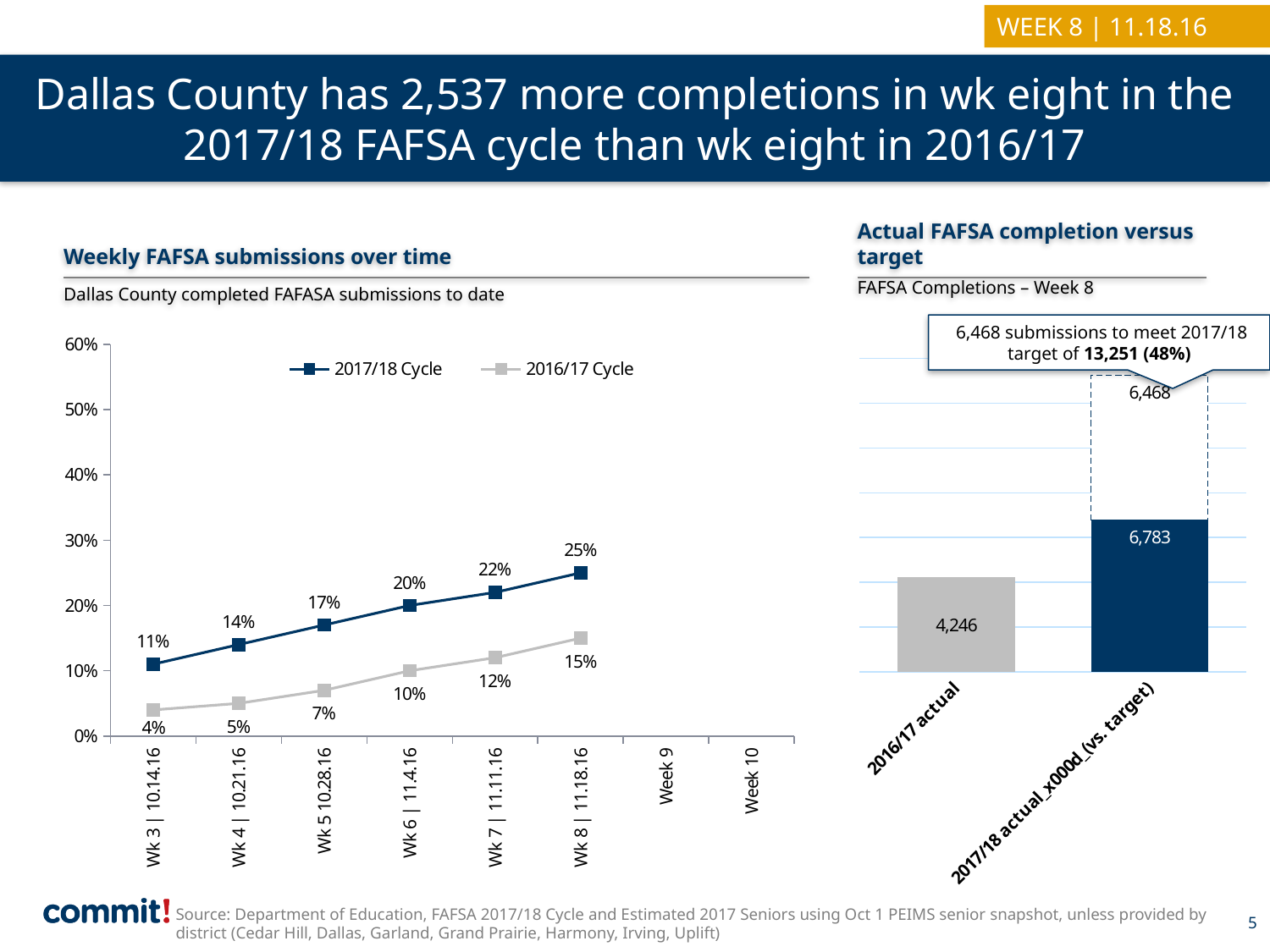
In the 'Actual FAFSA completion versus target' chart, what is the value for 2016/17 actual? 4,246 In the 'Weekly FAFSA submissions over time' chart, what kind of chart is shown? line chart In the 'Weekly FAFSA submissions over time' chart, what is the difference between the 2017/18 Cycle and 2016/17 Cycle values at Wk 6 | 11.4.16? 10% In the 'Actual FAFSA completion versus target' chart, what kind of chart is shown? bar chart In the 'Weekly FAFSA submissions over time' chart, does the 2017/18 Cycle rise or fall from Wk 3 to Wk 8? rise In the 'Actual FAFSA completion versus target' chart, what is the 2017/18 actual value? 6,783 In the 'Weekly FAFSA submissions over time' chart, what is the 2017/18 Cycle value at Wk 8 | 11.18.16? 25% In the 'Weekly FAFSA submissions over time' chart, how many series does the legend list? 2 In the 'Weekly FAFSA submissions over time' chart, which series is higher at Wk 7 | 11.11.16, 2017/18 Cycle or 2016/17 Cycle? 2017/18 Cycle In the 'Weekly FAFSA submissions over time' chart, which week has the lowest 2016/17 Cycle value? Wk 3 | 10.14.16 In the 'Weekly FAFSA submissions over time' chart, what is the 2016/17 Cycle value at Wk 5 10.28.16? 7% In the 'Actual FAFSA completion versus target' chart, how many more submissions are needed to meet the 2017/18 target? 6,468